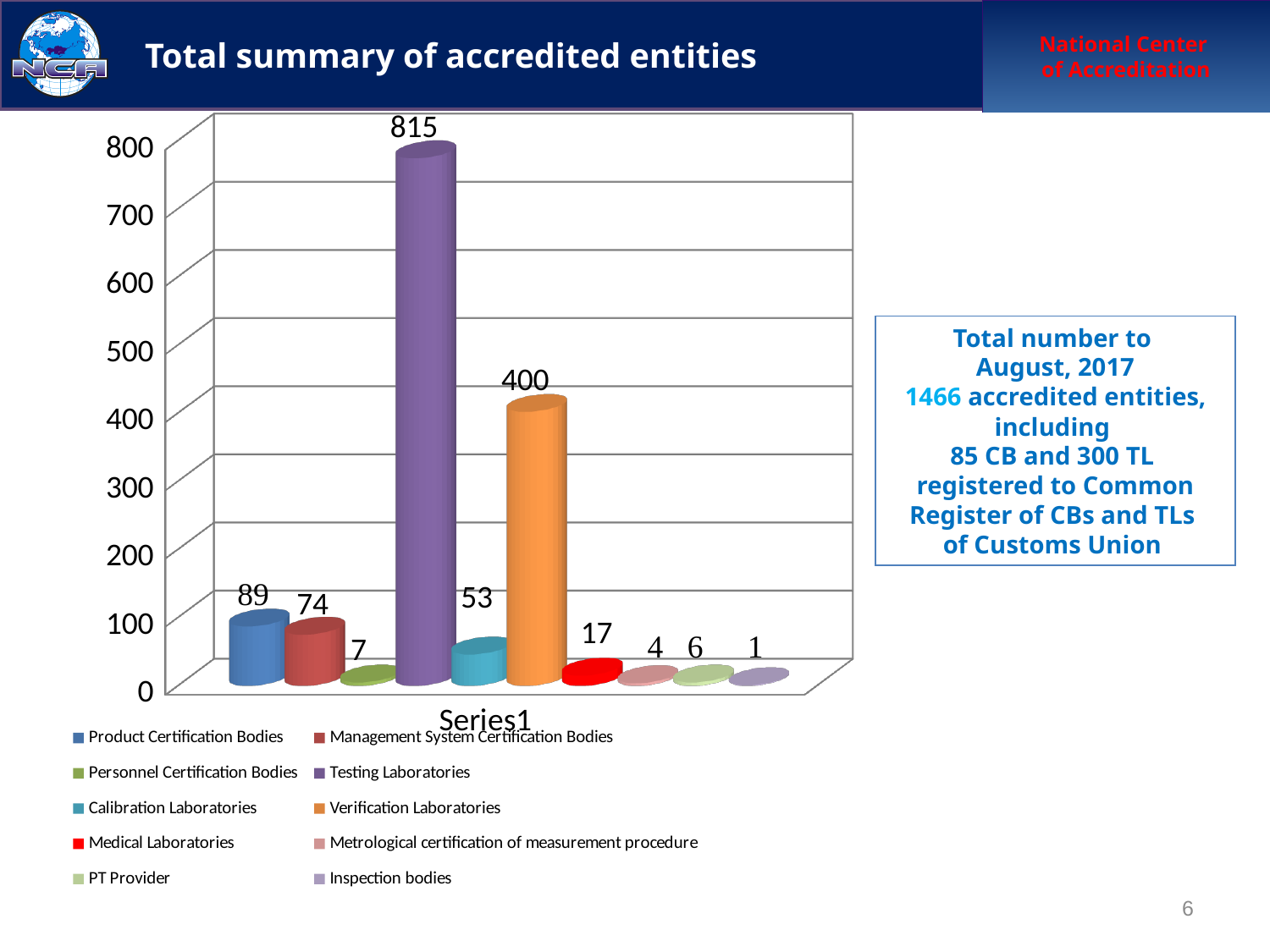
What is the difference between the values for Testing Laboratories and Verification Laboratories? 415 Which series has the highest value? Testing Laboratories Which is larger, the value for Product Certification Bodies or Management System Certification Bodies? Product Certification Bodies How many series does the legend list? 10 What is the value for Testing Laboratories? 815 What is the value for Product Certification Bodies? 89 What is the title of the chart? Total summary of accredited entities What is the value for Calibration Laboratories? 53 What is the value for Verification Laboratories? 400 Which series has the lowest value? Inspection bodies What kind of chart is shown on the slide? Bar chart Is the value for Verification Laboratories greater or less than 300? greater